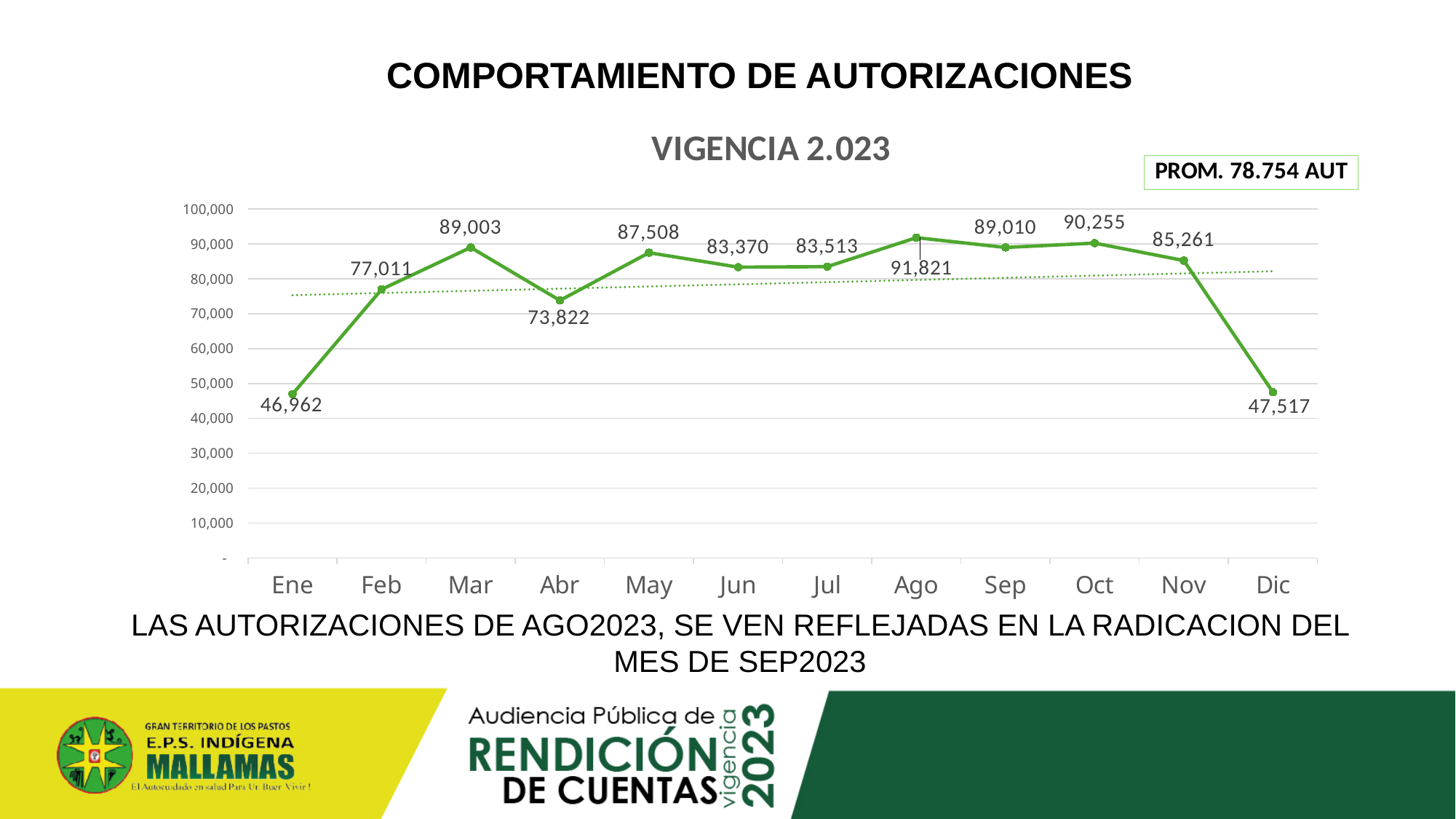
Which month has the lowest value in the chart? Ene What is the value for Dic in the chart? 47,517 What is the value for Ago in the VIGENCIA 2.023 chart? 91,821 What kind of chart is shown on the slide? line chart Which is larger, the value for Oct or the value for Sep? Oct How many months are plotted in the chart? 12 Is the value for Abr greater or less than 80,000? less Do the values rise or fall from Nov to Dic? fall Which month has the highest value in the chart? Ago What is the difference between the values for Ago and Ene? 44,859 What is the difference between the values for Mar and Abr? 15,181 What is the value for Abr in the chart? 73,822